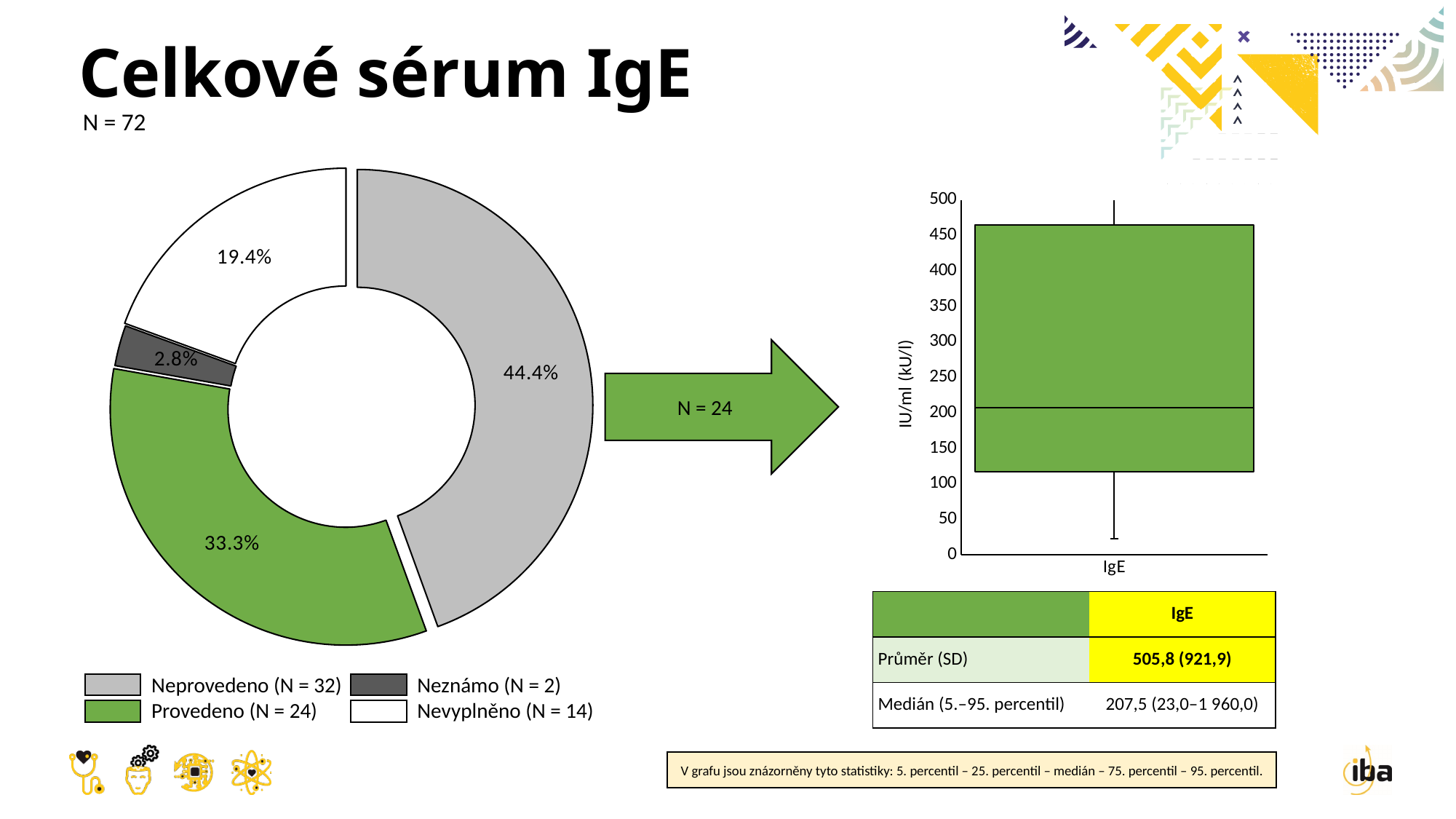
What kind of chart is shown on the right side of the slide? Box plot In the box plot on the right, is the median line for IgE greater or less than 150? greater In the donut chart on the left, what N is given for Neznámo in the legend? N = 2 In the donut chart on the left, which is larger: the share for Nevyplněno or the share for Neznámo? Nevyplněno In the box plot on the right, is the top of the box for IgE greater or less than 400? greater In the donut chart on the left, which category has the smallest share? Neznámo In the donut chart on the left, what percentage is shown for Provedeno? 33.3% In the donut chart on the left, which category has the largest share? Neprovedeno In the donut chart on the left, what percentage is shown for Neprovedeno? 44.4% In the donut chart on the left, what percentage is shown for Nevyplněno? 19.4% In the donut chart on the left, how many categories does the legend list? 4 In the donut chart on the left, what is the difference in percentage points between Neprovedeno and Provedeno? 11.1